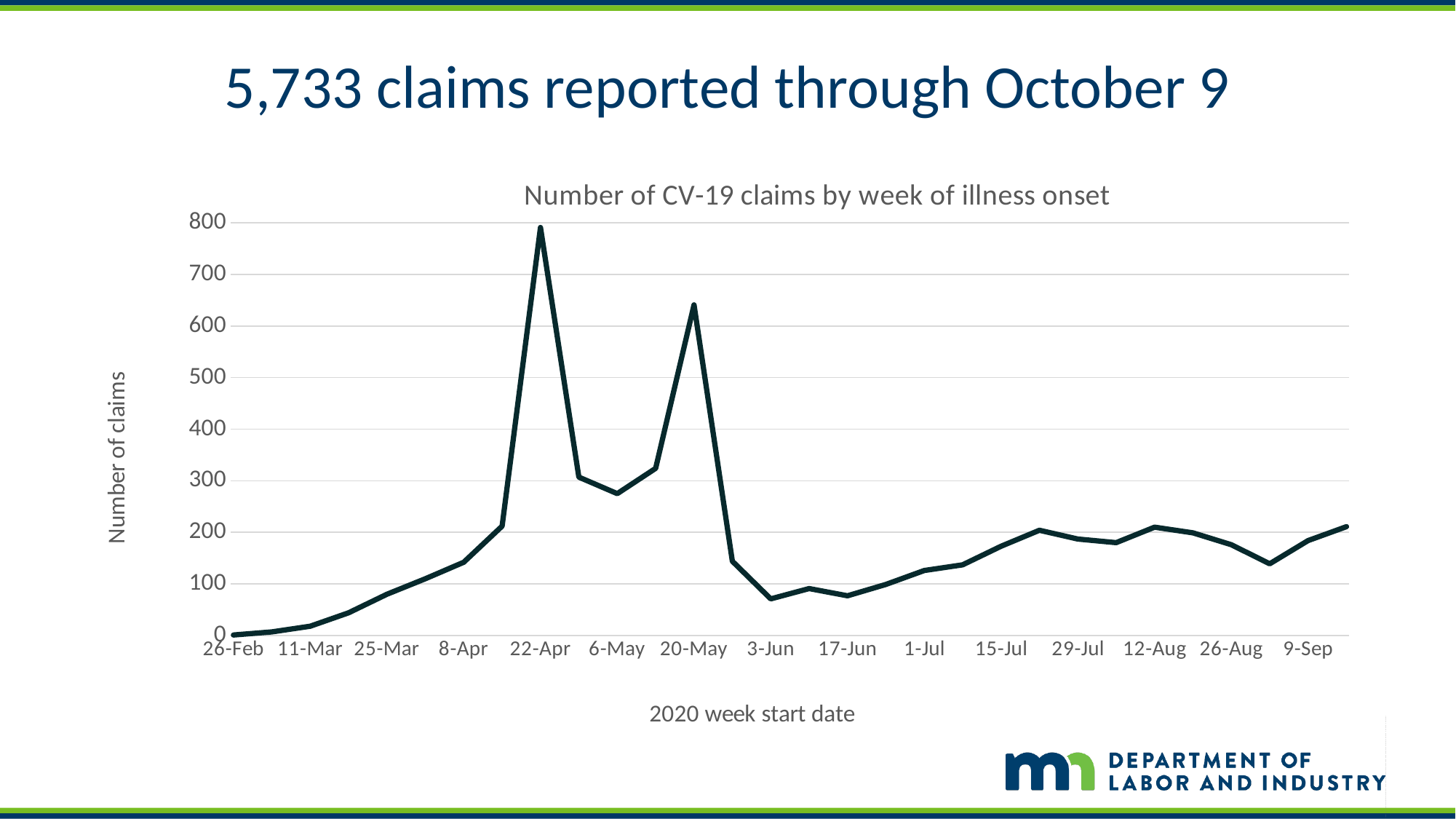
Is the value for 3-Jun greater or less than 100? less Do the values rise or fall from 26-Feb to 22-Apr? rise Is the value for 6-May greater or less than 400? less What is the title of the chart? Number of CV-19 claims by week of illness onset Which week start date has the highest number of claims? 22-Apr Which has more claims, the week of 22-Apr or the week of 20-May? 22-Apr Is the value for 20-May greater or less than 600? greater Which week start date has the lowest number of claims? 26-Feb What is the label on the vertical axis of the chart? Number of claims What kind of chart is shown on the slide? line chart